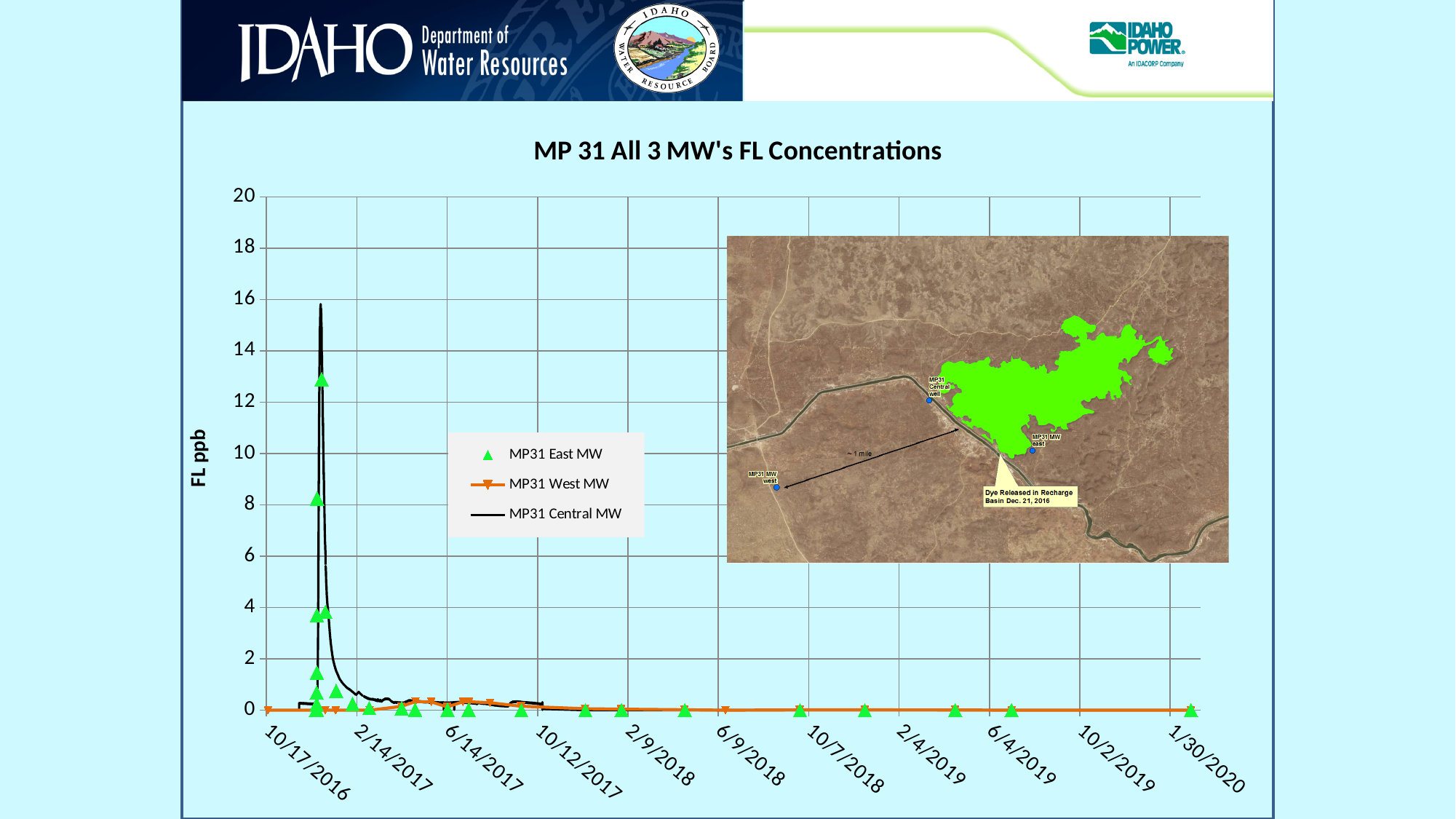
What is the title of the chart? MP 31 All 3 MW's FL Concentrations What is the label of the vertical axis? FL ppb What is the highest value shown on the vertical axis? 20 How many series does the legend list? 3 Is the highest MP31 West MW value greater or less than 2? less Is the highest MP31 East MW point greater or less than 12? greater Which series has the lowest peak value on the chart? MP31 West MW Which series reaches the highest FL concentration on the chart? MP31 Central MW After the spike in late 2016, do the FL concentrations rise or fall over the rest of the x axis? fall What kind of chart is shown on the slide? line chart Is the peak value of the MP31 Central MW series greater or less than 14? greater